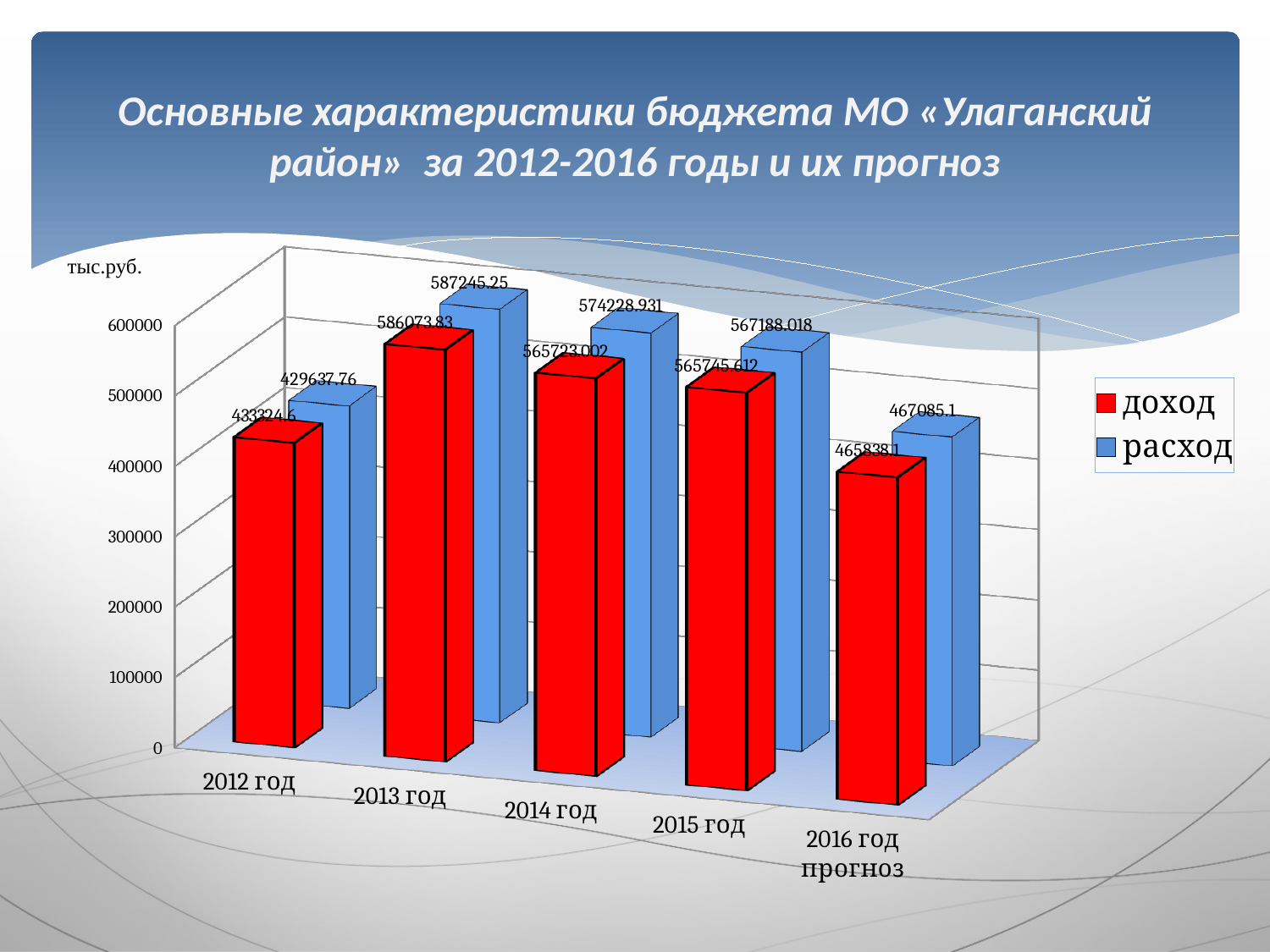
What is the difference between доход and расход for 2012 год? 3686.84 What is the value of расход for 2014 год? 574228.931 What is the value of доход for 2012 год? 433324.6 What is the value of расход for 2013 год? 587245.25 How many series does the legend list? 2 In which year is доход the lowest? 2012 год What is the value of доход for 2016 год прогноз? 465838.1 What is the difference between расход and доход for 2013 год? 1171.42 In which year is расход the highest? 2013 год For 2014 год, which is larger: доход or расход? расход How many year categories are shown on the x axis? 5 What kind of chart is shown on the slide? bar chart